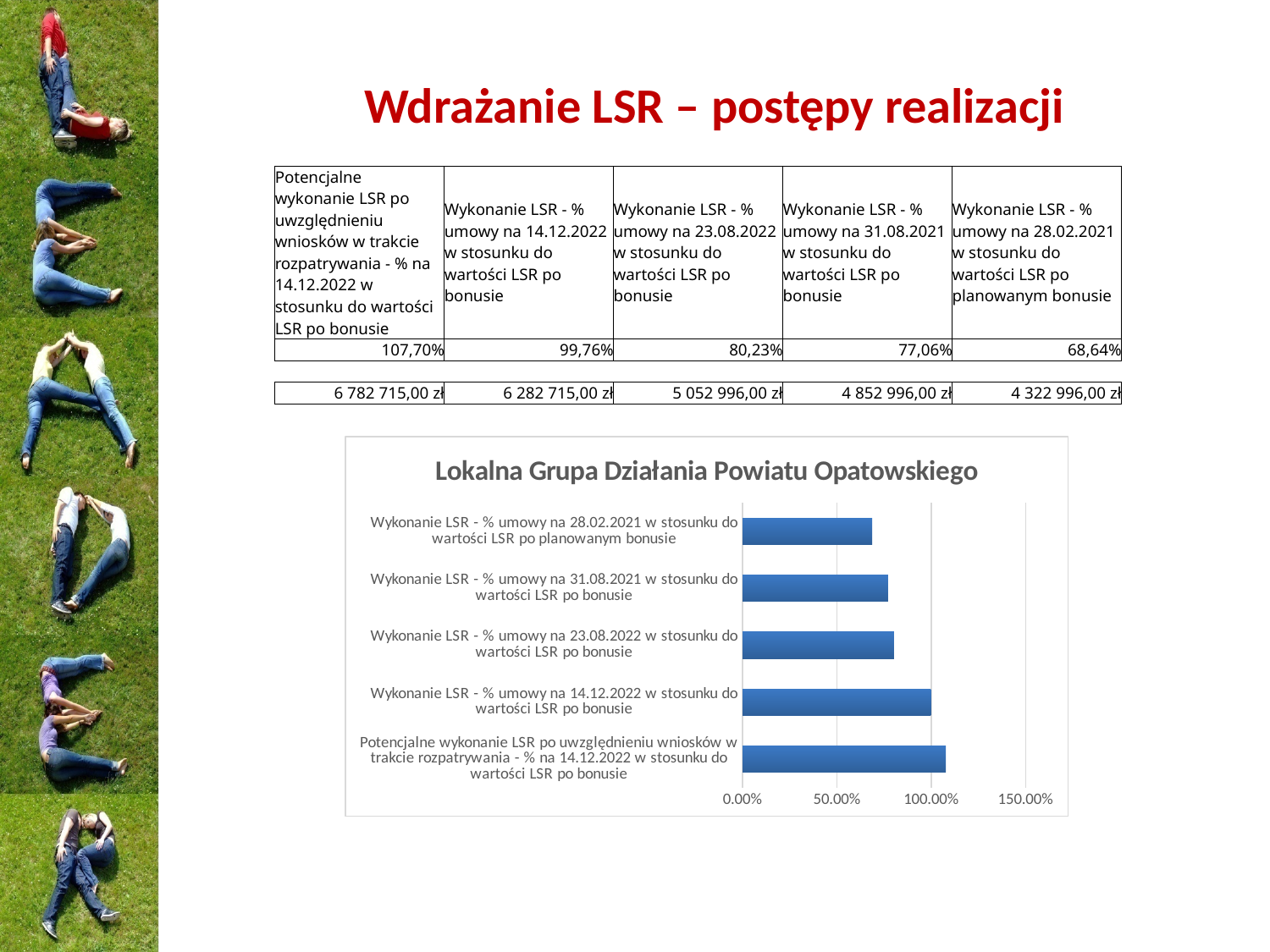
Is the value for 'Potencjalne wykonanie LSR po uwzględnieniu wniosków w trakcie rozpatrywania' greater or less than 100.00%? greater Which category has the longest bar in the chart? Potencjalne wykonanie LSR po uwzględnieniu wniosków w trakcie rozpatrywania - % na 14.12.2022 w stosunku do wartości LSR po bonusie Reading the bars from top to bottom, do the values get larger or smaller? larger What kind of chart is shown on the slide? bar chart Which category has the shortest bar in the chart? Wykonanie LSR - % umowy na 28.02.2021 w stosunku do wartości LSR po planowanym bonusie According to the table above the chart, what is the value for 'Wykonanie LSR - % umowy na 14.12.2022 w stosunku do wartości LSR po bonusie'? 99,76% According to the table above the chart, what is the value for 'Wykonanie LSR - % umowy na 28.02.2021 w stosunku do wartości LSR po planowanym bonusie'? 68,64% What is the title of the chart? Lokalna Grupa Działania Powiatu Opatowskiego Which is larger: the bar for 'Wykonanie LSR - % umowy na 14.12.2022' or the bar for 'Wykonanie LSR - % umowy na 23.08.2022'? Wykonanie LSR - % umowy na 14.12.2022 Is the value for 'Wykonanie LSR - % umowy na 31.08.2021 w stosunku do wartości LSR po bonusie' greater or less than 50.00%? greater Is the value for 'Wykonanie LSR - % umowy na 28.02.2021 w stosunku do wartości LSR po planowanym bonusie' greater or less than 100.00%? less How many bars (categories) does the chart show? 5